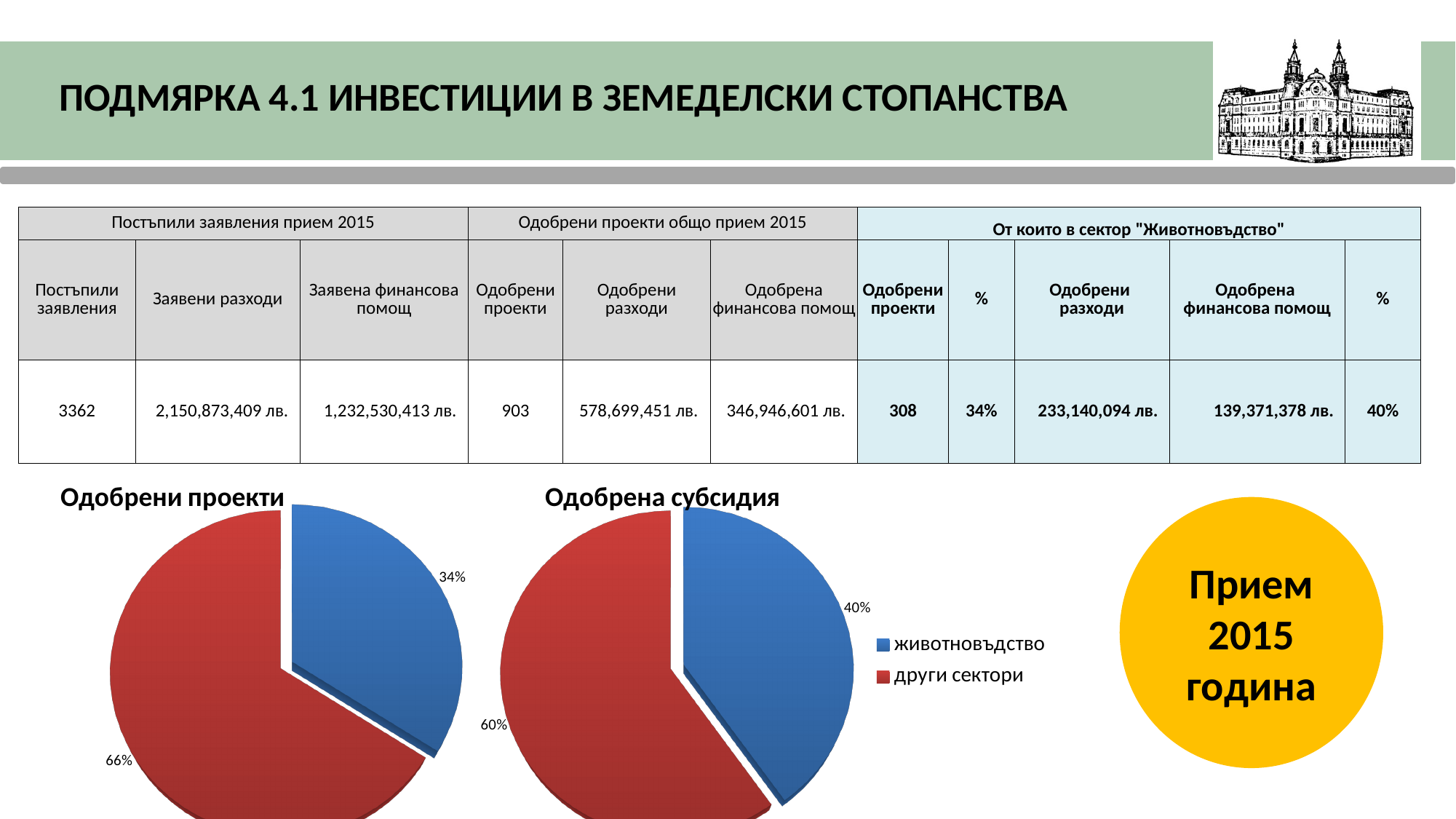
How many slices does the "Одобрена субсидия" chart have? 2 In the "Одобрени проекти" chart, what share does "животновъдство" have? 34% In the "Одобрена субсидия" chart, what is the difference in percentage points between "други сектори" and "животновъдство"? 20 In the "Одобрени проекти" chart, what is the difference in percentage points between "други сектори" and "животновъдство"? 32 In the "Одобрена субсидия" chart, which slice is the smallest? животновъдство In the "Одобрени проекти" chart, which slice is the largest? други сектори What type of chart is "Одобрени проекти"? Pie chart In the "Одобрени проекти" chart, what share does "други сектори" have? 66% Which colour represents "други сектори" in the pie charts? Red Which chart shows a larger share for "животновъдство": "Одобрени проекти" or "Одобрена субсидия"? Одобрена субсидия In the "Одобрена субсидия" chart, what share does "други сектори" have? 60% In the "Одобрена субсидия" chart, what share does "животновъдство" have? 40%